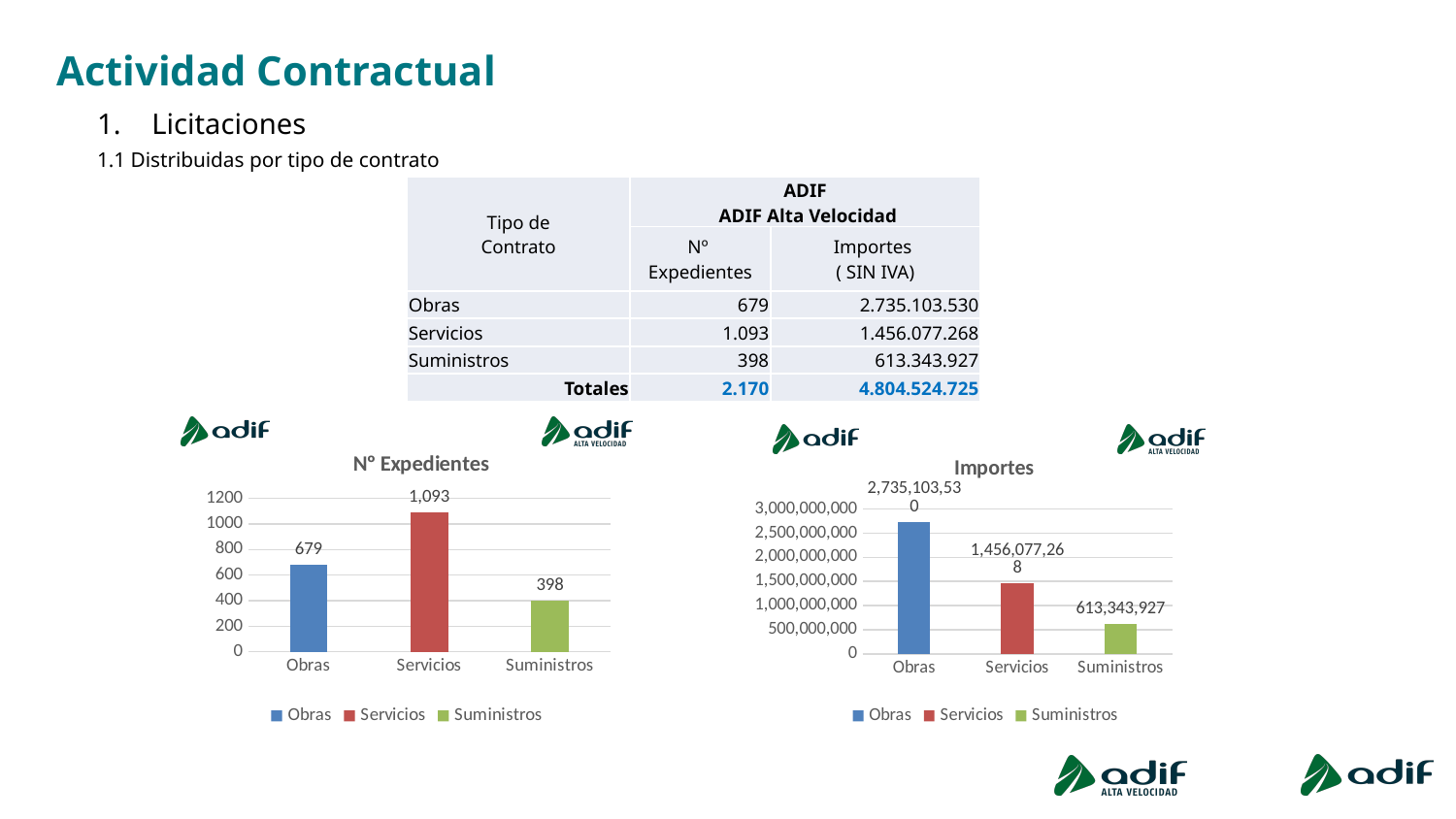
In the 'Importes' chart, which category has the highest value? Obras In the 'Importes' chart, is the value for Servicios greater or less than 1,000,000,000? greater In the 'Nº Expedientes' chart, what is the value for Servicios? 1,093 In the 'Importes' chart, which is larger, Servicios or Suministros? Servicios How many categories are shown in the 'Nº Expedientes' chart? 3 In the 'Nº Expedientes' chart, what is the value for Suministros? 398 In the 'Nº Expedientes' chart, what is the difference between Servicios and Obras? 414 In the 'Nº Expedientes' chart, which category has the highest value? Servicios In the 'Importes' chart, what is the value for Suministros? 613,343,927 In the 'Nº Expedientes' chart, which category has the lowest value? Suministros What type of chart is the 'Importes' chart? Bar chart In the 'Importes' chart, what is the value for Obras? 2,735,103,530